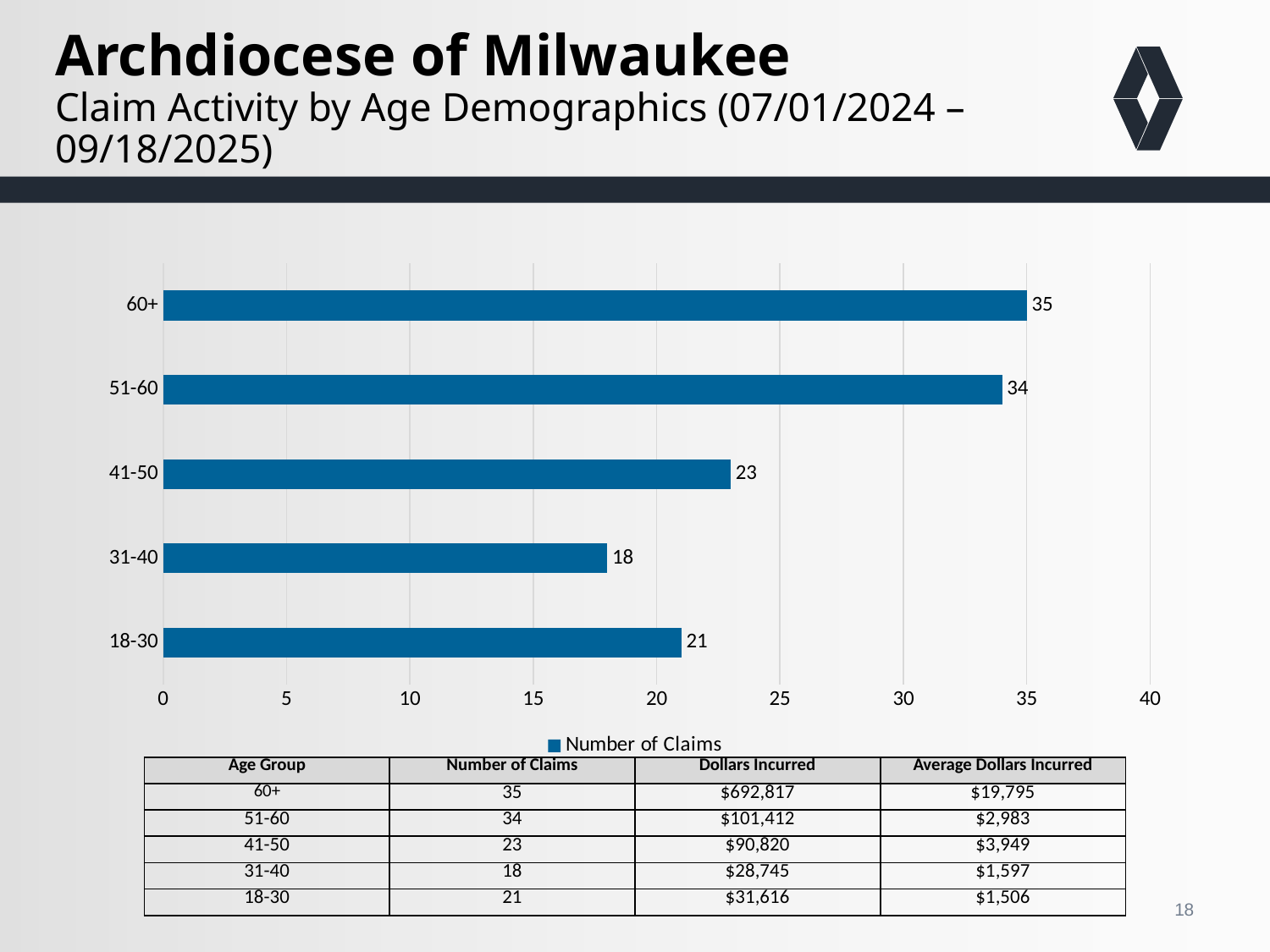
What is the number of claims for the 31-40 age group? 18 Is the number of claims for the 51-60 age group greater or less than 30? greater How many series does the legend list? 1 What type of chart is shown on the slide? Bar chart What is the number of claims for the 60+ age group? 35 Which age group has the lowest number of claims? 31-40 What is the difference in number of claims between the 60+ and 41-50 age groups? 12 Which age group has the highest number of claims? 60+ What is the number of claims for the 18-30 age group? 21 What is the legend entry for the series in the chart? Number of Claims How many age groups are shown in the chart? 5 Which age group has more claims, 18-30 or 41-50? 41-50